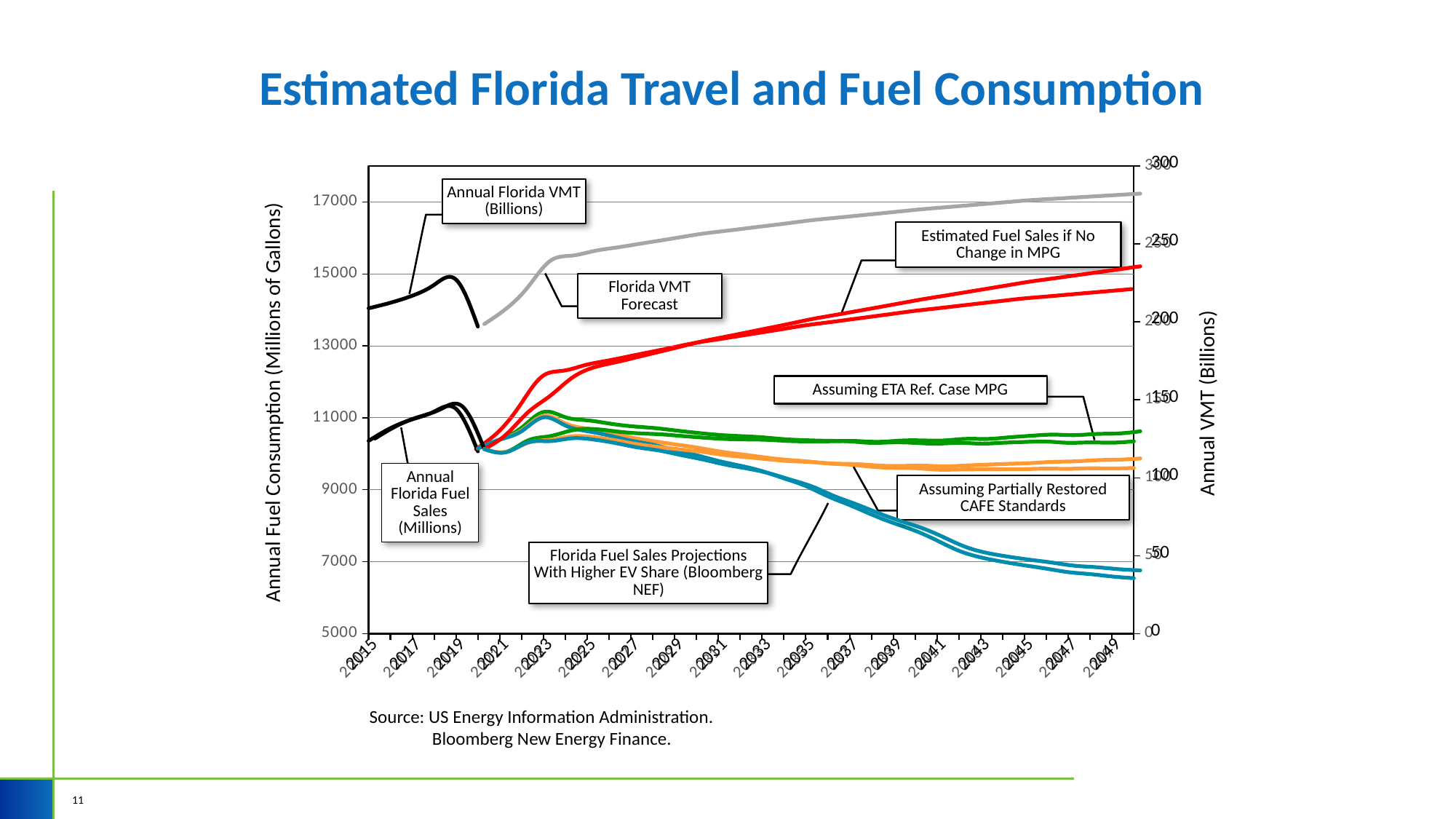
Which series is plotted lowest on the chart in 2049? Florida Fuel Sales Projections With Higher EV Share (Bloomberg NEF) What is the label of the left vertical axis? Annual Fuel Consumption (Millions of Gallons) Is the value for Estimated Fuel Sales if No Change in MPG in 2049 greater or less than 13000? greater Is the value for Florida VMT Forecast in 2049 greater or less than 250 on the right axis? greater What is the title of the chart on the slide? Estimated Florida Travel and Fuel Consumption Is the value for Annual Florida Fuel Sales in 2015 greater or less than 11000? less What kind of chart is shown on the slide? line chart Does the Florida VMT Forecast line rise or fall between 2021 and 2049? rise In 2049, which is higher: Assuming ETA Ref. Case MPG or Assuming Partially Restored CAFE Standards? Assuming ETA Ref. Case MPG Does the Estimated Fuel Sales if No Change in MPG line rise or fall between 2021 and 2049? rise Does the Florida Fuel Sales Projections With Higher EV Share (Bloomberg NEF) line rise or fall between 2025 and 2049? fall